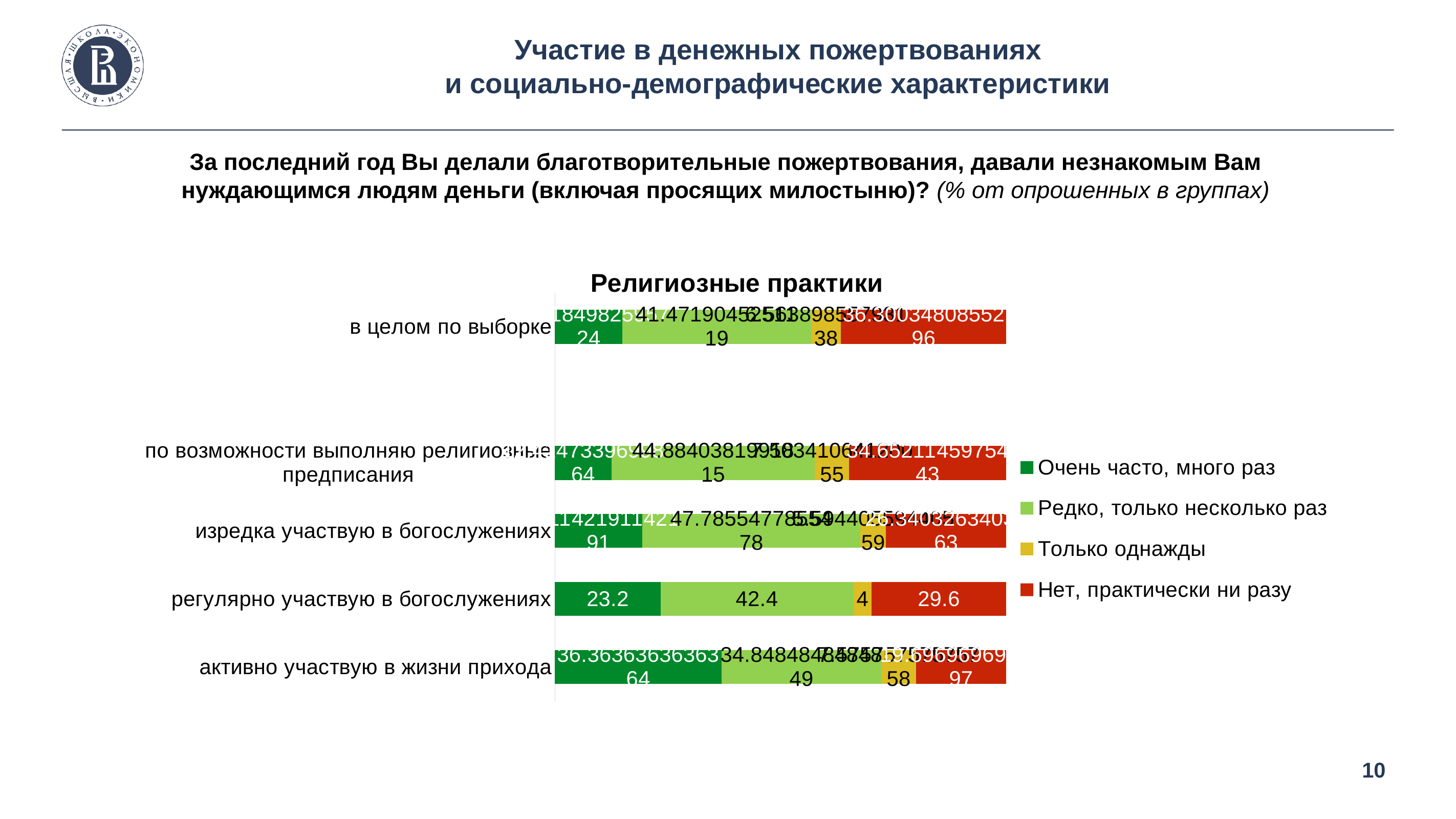
For the group "регулярно участвую в богослужениях", what is the difference between "Редко, только несколько раз" and "Очень часто, много раз"? 19.2 For the group "регулярно участвую в богослужениях", which series has the smallest value? Только однажды What is the value of "Только однажды" for the group "регулярно участвую в богослужениях"? 4 What is the value of "Нет, практически ни разу" for the group "регулярно участвую в богослужениях"? 29.6 What is the value of "Редко, только несколько раз" for the group "регулярно участвую в богослужениях"? 42.4 How many categories (groups) are plotted on the chart? 5 What is the title of the chart? Религиозные практики How many series does the legend of the chart list? 4 What is the value of "Очень часто, много раз" for the group "регулярно участвую в богослужениях"? 23.2 What is the total of the stacked bar for "регулярно участвую в богослужениях"? 99.2 For the group "регулярно участвую в богослужениях", which series has the largest value? Редко, только несколько раз What kind of chart is shown on the slide? bar chart